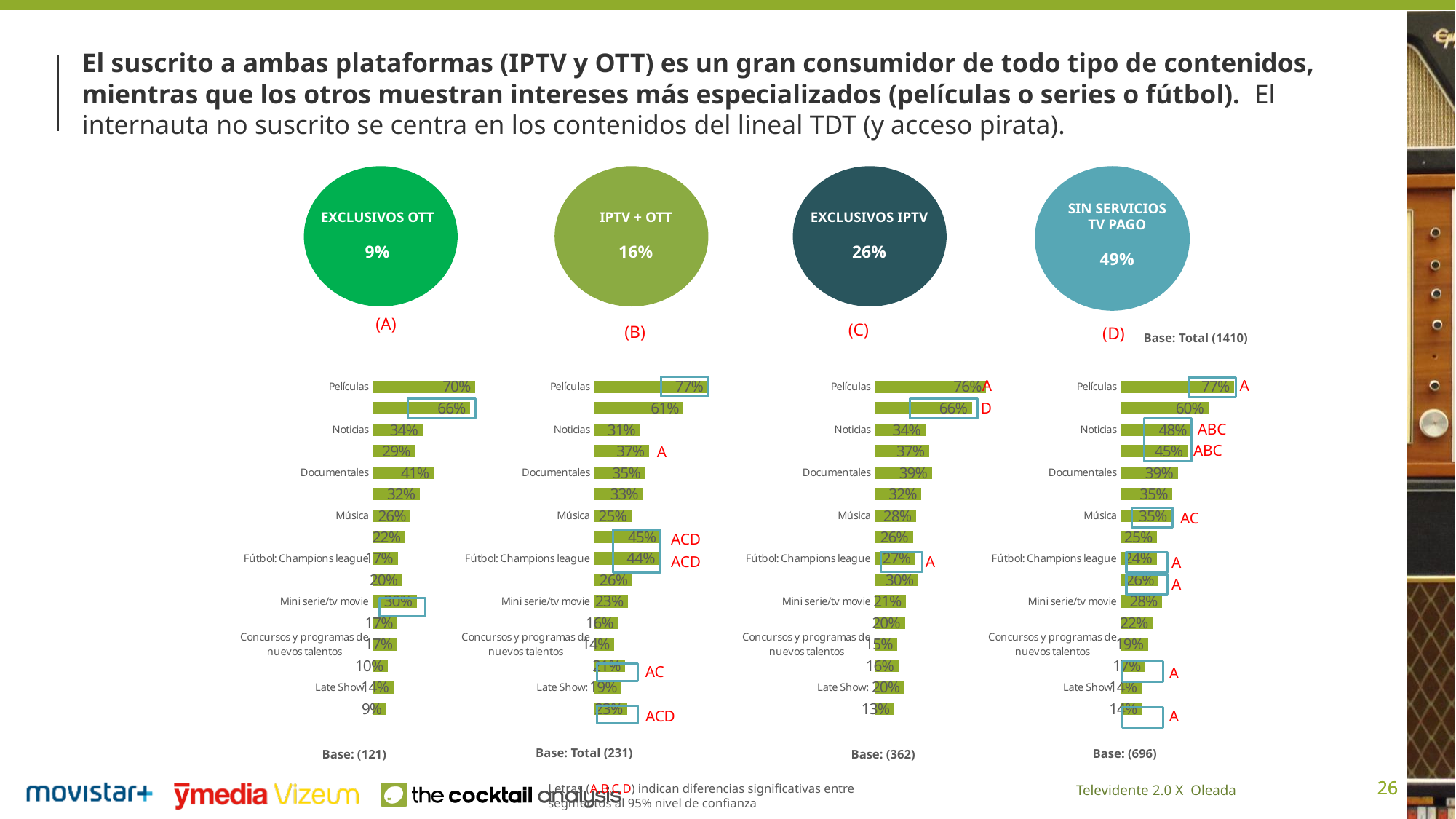
In the IPTV + OTT chart, what is the value for Fútbol: Champions league? 44% In the IPTV + OTT chart, what is the difference between Películas and Fútbol: Champions league? 33 percentage points In the EXCLUSIVOS IPTV chart, what is the value for Documentales? 39% What percentage is shown in the SIN SERVICIOS TV PAGO circle? 49% Which is larger, Fútbol: Champions league in the IPTV + OTT chart or Fútbol: Champions league in the SIN SERVICIOS TV PAGO chart? IPTV + OTT In the SIN SERVICIOS TV PAGO chart, what is the value for Noticias? 48% In the EXCLUSIVOS OTT chart, what is the value for Películas? 70% In the IPTV + OTT chart, which labeled category has the highest value? Películas In the SIN SERVICIOS TV PAGO chart, what is the value for Música? 35% In the EXCLUSIVOS OTT chart, which labeled category has the lowest value? Late Show In the EXCLUSIVOS IPTV chart, which is larger, Noticias or Música? Noticias What kind of chart is used under each segment circle? Bar chart